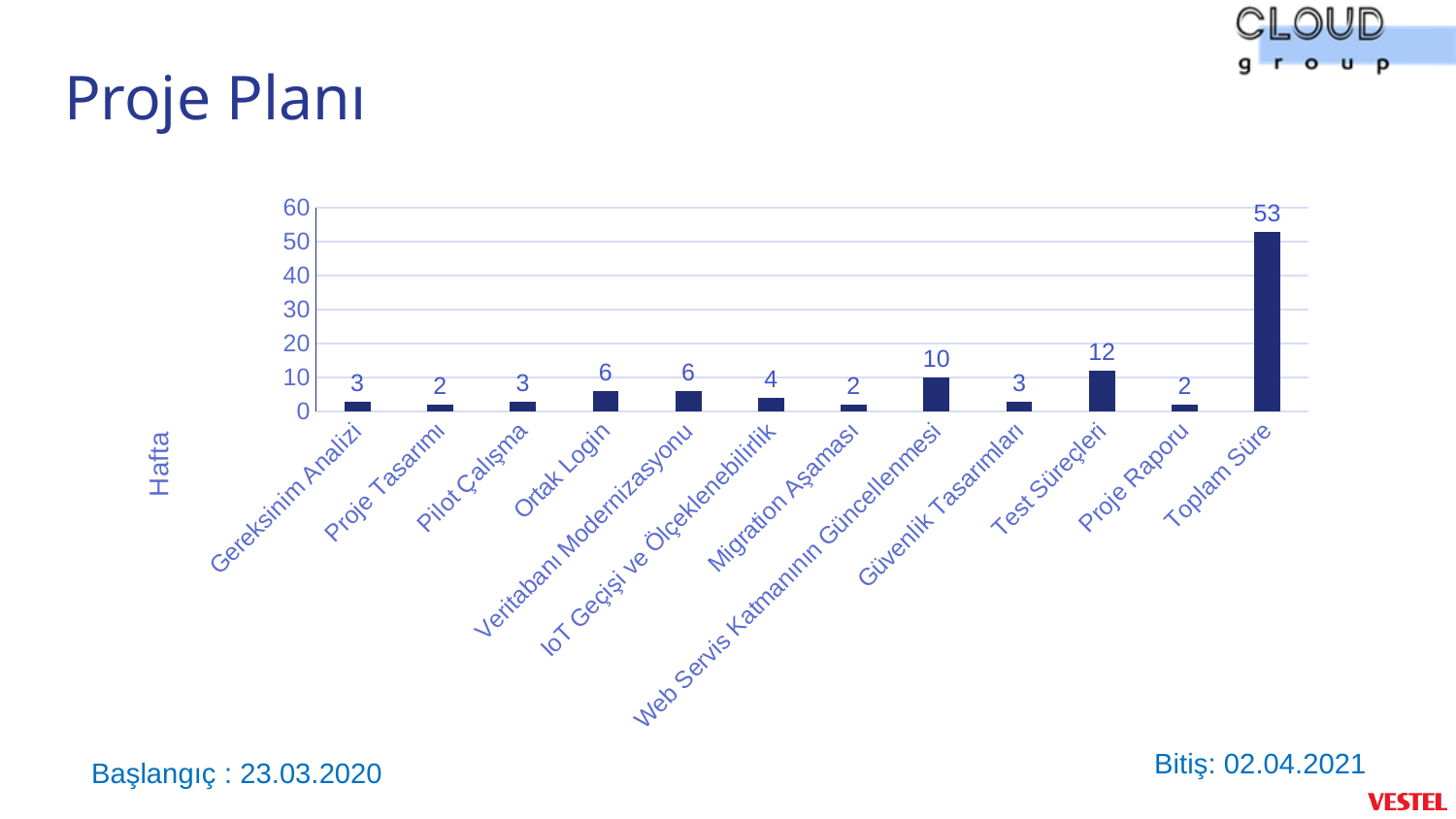
What is the label on the vertical axis of the chart? Hafta Which category has the highest value? Toplam Süre How many categories are plotted on the x axis of the chart? 12 What is the difference between the values for Test Süreçleri and Web Servis Katmanının Güncellenmesi? 2 What is the value for IoT Geçişi ve Ölçeklenebilirlik? 4 Which is larger, the value for Ortak Login or the value for Migration Aşaması? Ortak Login What is the value for Toplam Süre? 53 What kind of chart is shown on the slide? bar chart What is the value for Test Süreçleri? 12 Is the value for Toplam Süre greater or less than 50? greater What is the value for Web Servis Katmanının Güncellenmesi? 10 Excluding Toplam Süre, which category has the highest value? Test Süreçleri